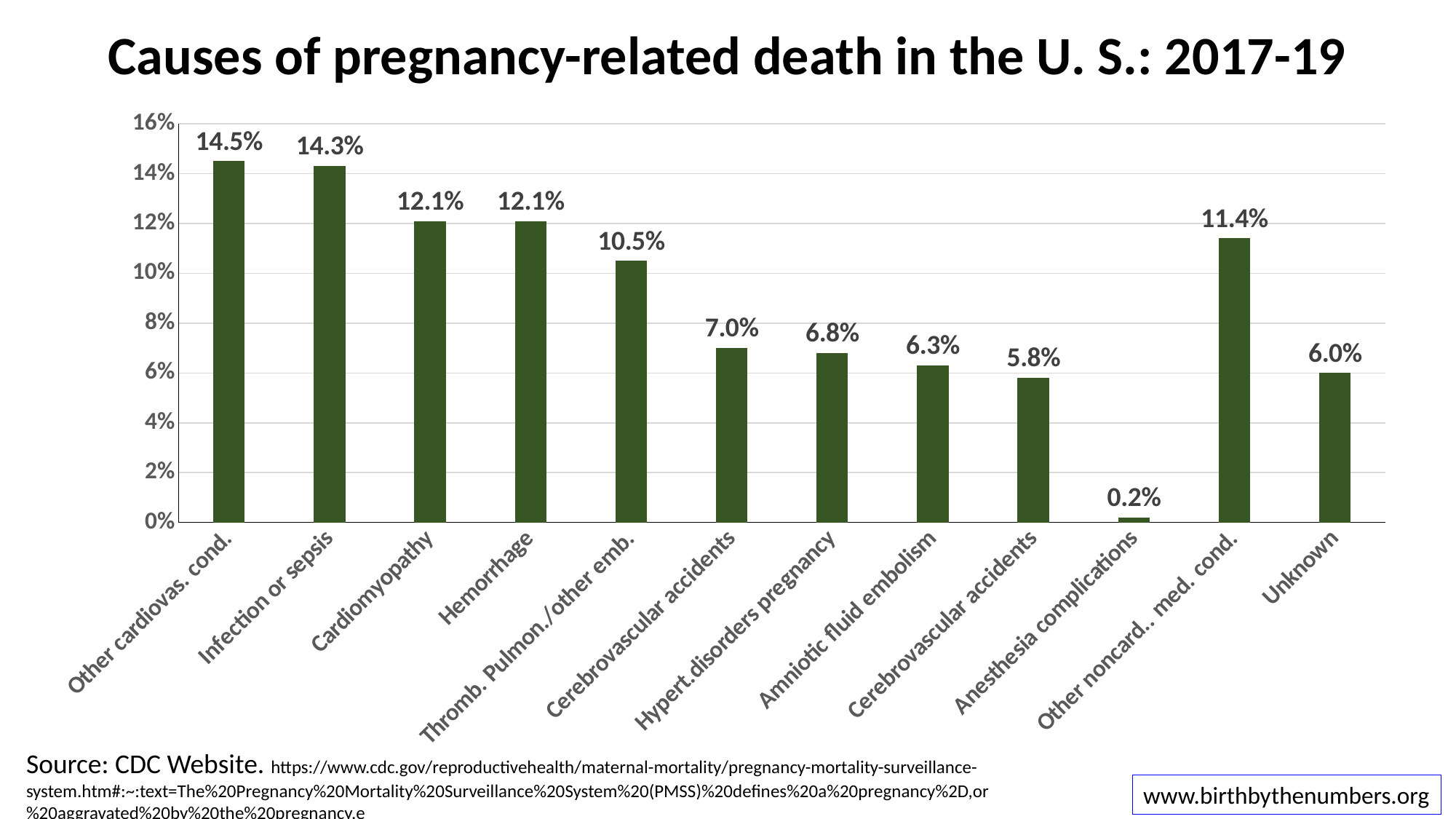
What is the value for Thromb. Pulmon./other emb.? 10.5% Which cause has the highest value? Other cardiovas. cond. Which is larger, the value for Amniotic fluid embolism or the value for Unknown? Amniotic fluid embolism What is the title of the chart? Causes of pregnancy-related death in the U. S.: 2017-19 What kind of chart is shown on the slide? Bar chart How many causes are plotted on the chart? 12 Is the value for Other noncard.. med. cond. greater or less than 10%? greater What is the difference between the values for Hemorrhage and Unknown? 6.1 percentage points What is the value for Unknown? 6.0% What is the value for Other noncard.. med. cond.? 11.4% Which cause has the lowest value? Anesthesia complications What is the value for Infection or sepsis? 14.3%